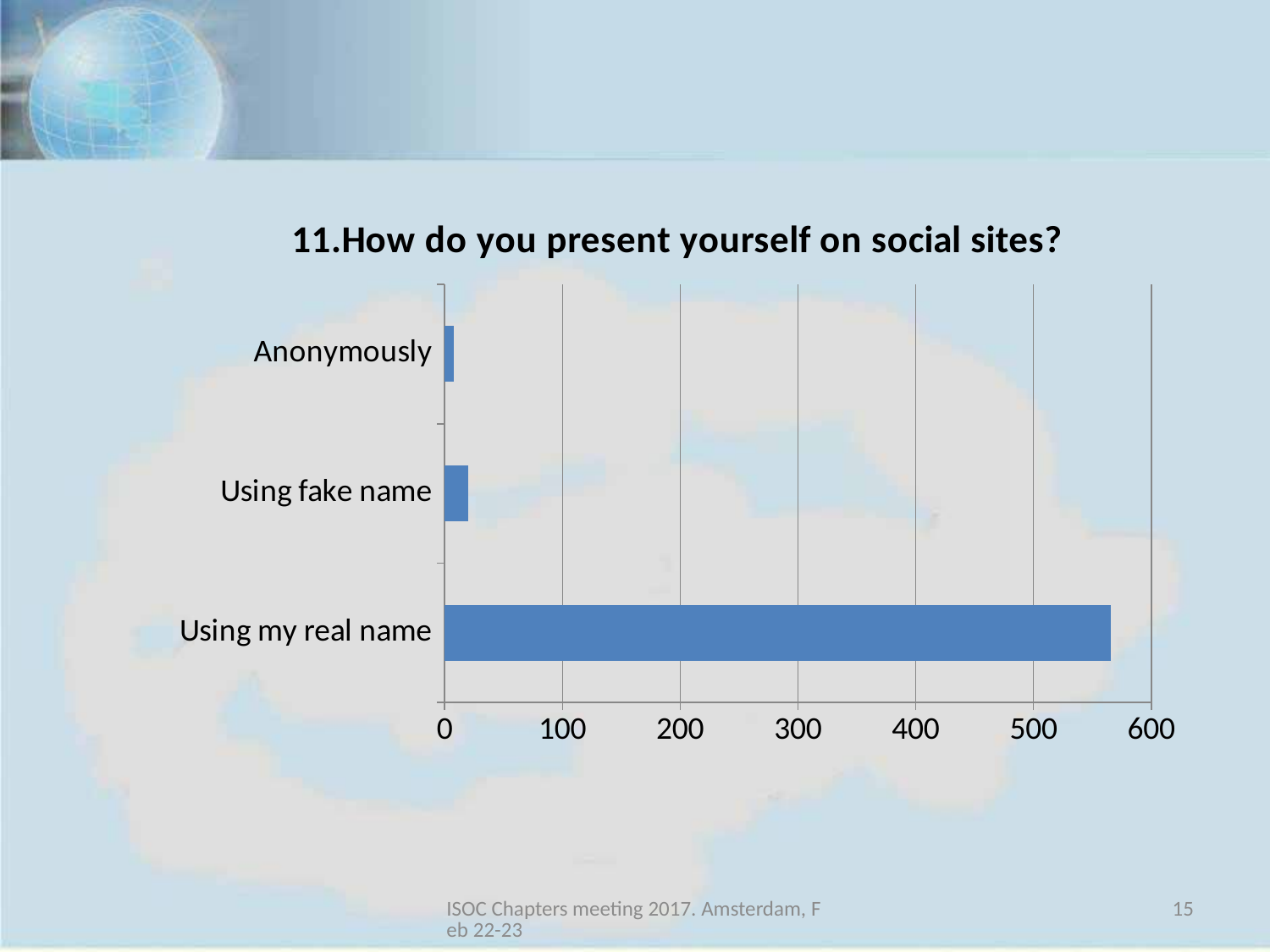
What is the maximum value shown on the horizontal axis? 600 How many categories does the chart show? 3 Which is larger, the value for Using fake name or the value for Anonymously? Using fake name Is the value for Using my real name greater or less than 500? greater Is the value for Using fake name greater or less than 100? less What is the title of the chart? 11.How do you present yourself on social sites? Which is larger, the value for Using my real name or the value for Using fake name? Using my real name Is the value for Anonymously greater or less than 100? less What kind of chart is shown on the slide? bar chart Which category has the highest value? Using my real name Which category has the lowest value? Anonymously